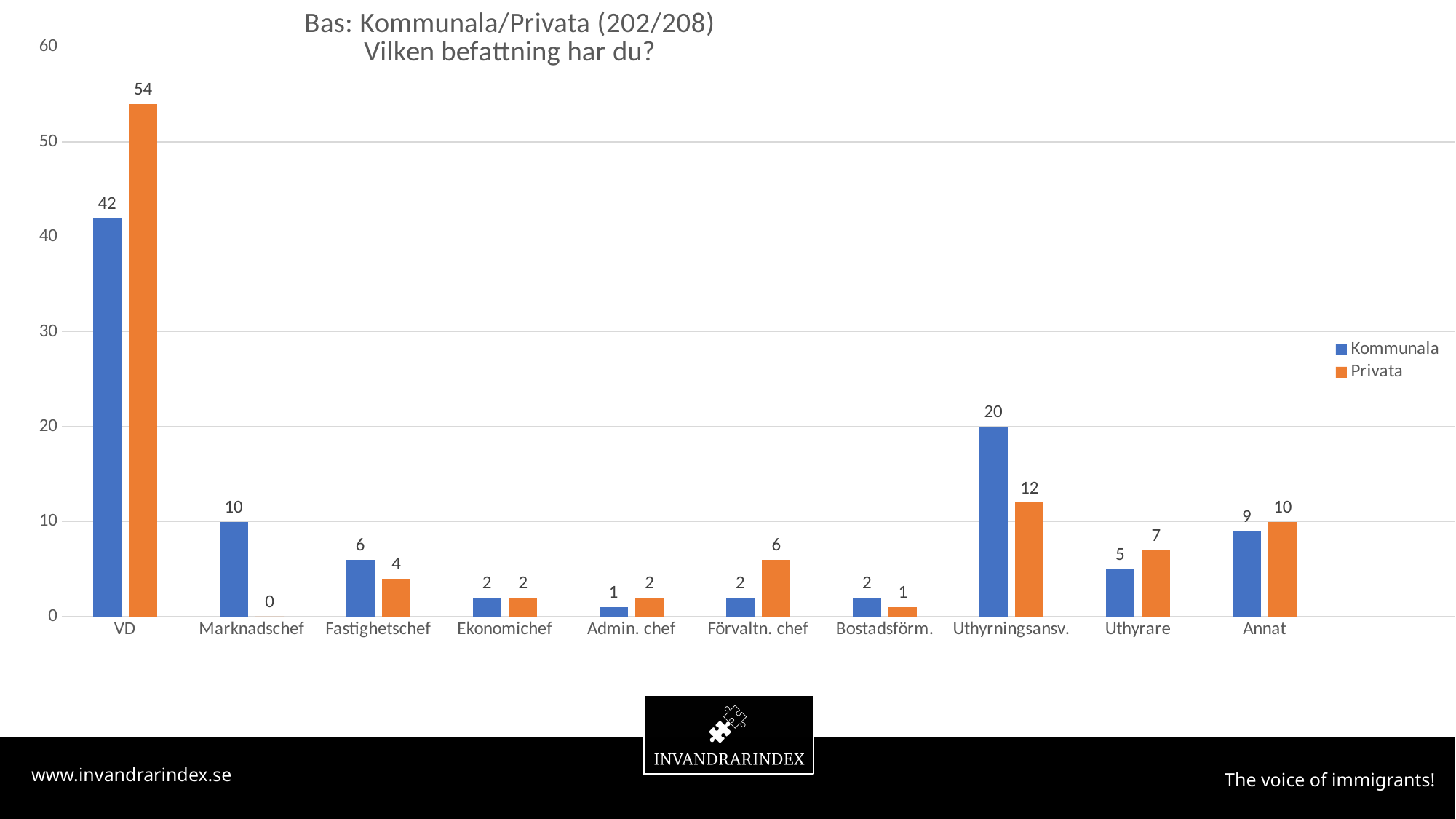
Is the Privata value for VD greater or less than 50? greater What is the Kommunala value for VD? 42 How many series does the legend list? 2 Which is larger for Uthyrningsansv., the Kommunala value or the Privata value? Kommunala What is the difference between the Privata and Kommunala values for VD? 12 What is the Privata value for Marknadschef? 0 Which category has the highest Privata value? VD How many categories are shown on the x axis? 10 Which category has the lowest Kommunala value? Admin. chef What kind of chart is shown? bar chart Which colour represents the Privata series? orange What is the Privata value for Uthyrningsansv.? 12